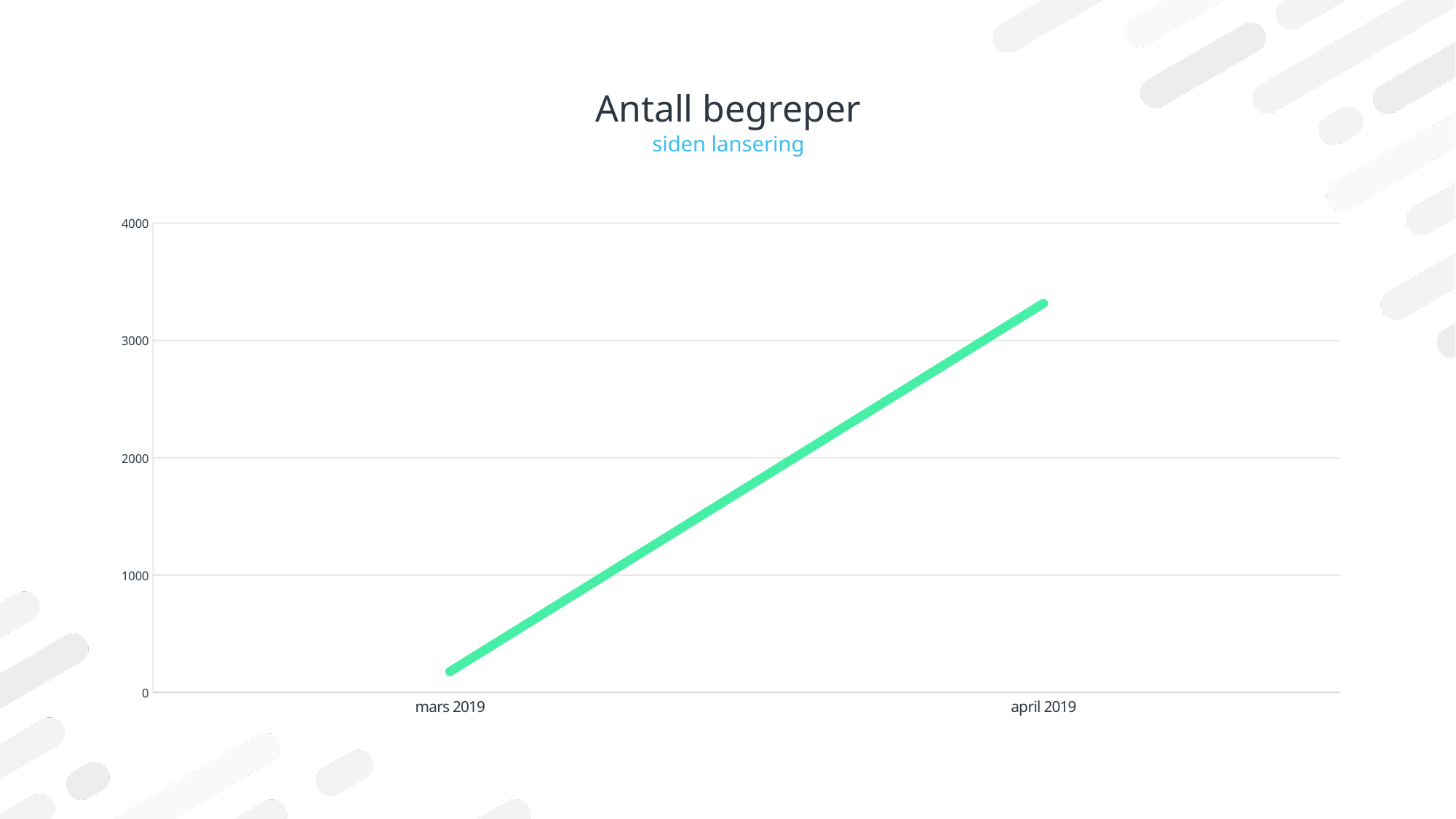
Is the value for april 2019 greater or less than 3000? greater What is the subtitle shown under the chart title? siden lansering Which category has the lowest value? mars 2019 Do the values rise or fall from mars 2019 to april 2019? rise Is the value for april 2019 greater or less than 4000? less Which category has the highest value? april 2019 What is the highest value shown on the y axis? 4000 Which is larger, the value for mars 2019 or the value for april 2019? april 2019 What kind of chart is shown on the slide? line chart Is the value for mars 2019 greater or less than 1000? less How many points are plotted on the line? 2 What is the title of the chart? Antall begreper